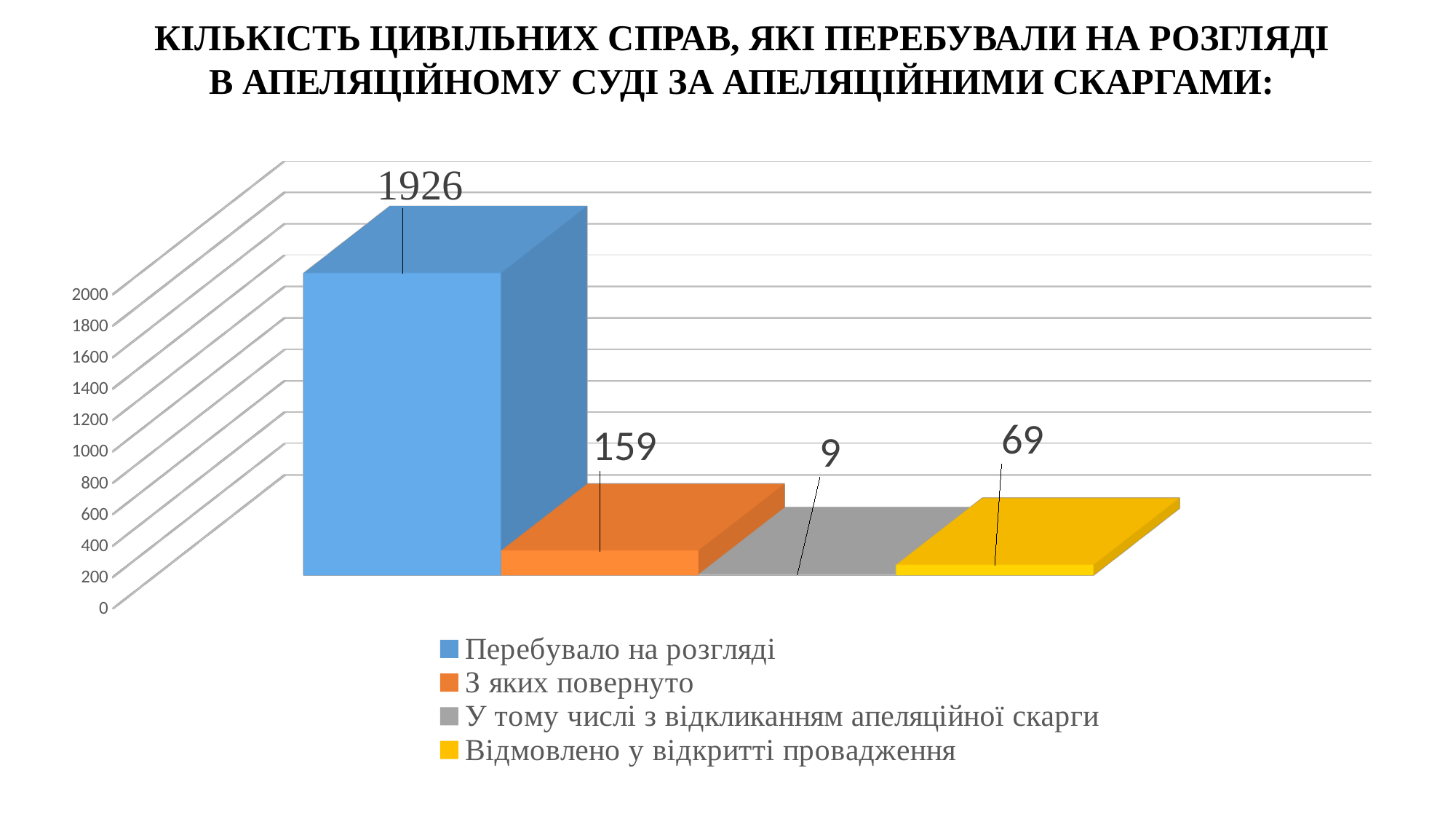
Which series has the highest value? Перебувало на розгляді What is the value for "Відмовлено у відкритті провадження"? 69 What is the value for "Перебувало на розгляді"? 1926 What is the value for "З яких повернуто"? 159 What kind of chart is shown on the slide? Bar chart What is the difference between "Перебувало на розгляді" and "З яких повернуто"? 1767 Which is larger: "Відмовлено у відкритті провадження" or "У тому числі з відкликанням апеляційної скарги"? Відмовлено у відкритті провадження Which series has the lowest value? У тому числі з відкликанням апеляційної скарги What is the difference between "З яких повернуто" and "Відмовлено у відкритті провадження"? 90 What colour is the bar for "З яких повернуто"? Orange What is the value for "У тому числі з відкликанням апеляційної скарги"? 9 How many series does the legend list? 4